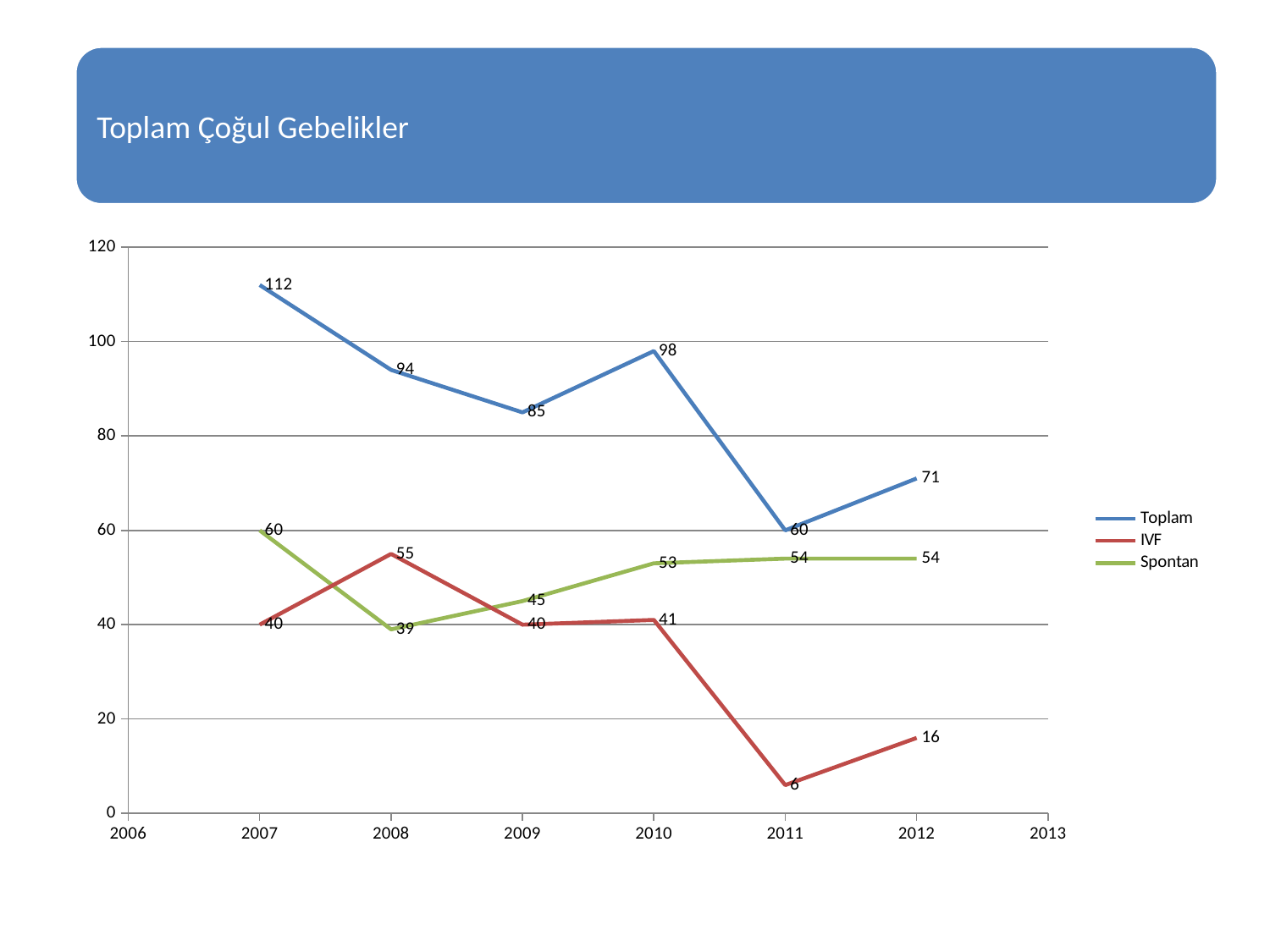
What is the title of the slide? Toplam Çoğul Gebelikler How many series does the legend list? 3 Is the Toplam value for 2010 greater or less than 80? greater In which year is the IVF series highest? 2008 What is the Spontan value for 2010? 53 What is the IVF value for 2011? 6 What is the Toplam value for 2007? 112 Which is larger in 2008, the IVF value or the Spontan value? IVF What kind of chart is shown on the slide? line chart In which year is the Toplam series lowest? 2011 What is the difference between the Toplam values for 2007 and 2012? 41 Does the Spontan series rise or fall from 2008 to 2012? rise